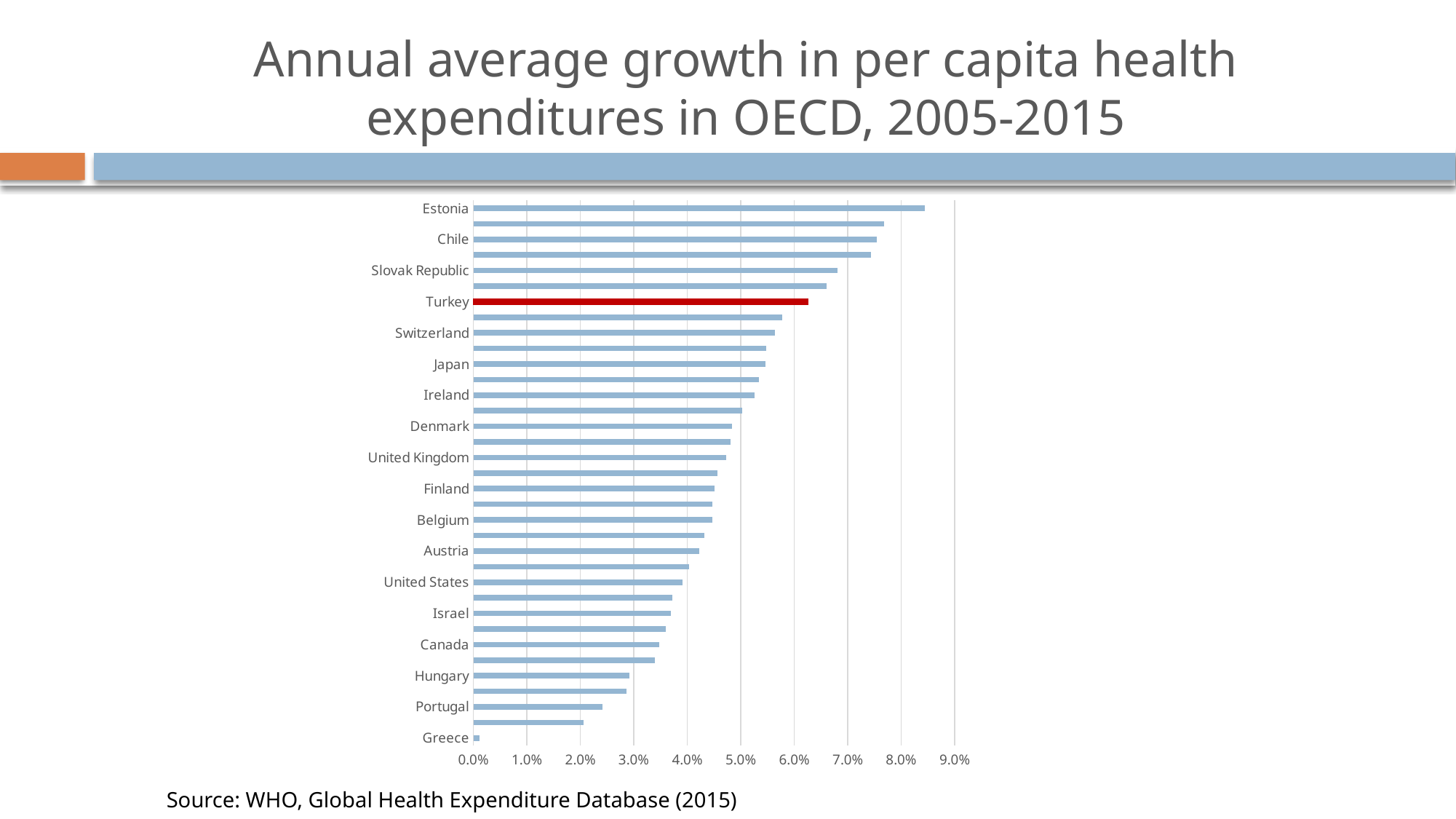
Which country has the highest annual average growth in per capita health expenditures? Estonia Is the value for Portugal greater or less than 3.0%? less Is the value for Greece greater or less than 1.0%? less Which country has the lowest annual average growth in per capita health expenditures? Greece Is the value for Chile greater or less than 7.0%? greater What kind of chart is shown on the slide? bar chart Which country's bar is highlighted in red? Turkey Which has a higher value, Turkey or Switzerland? Turkey Which has a higher value, Chile or Japan? Chile